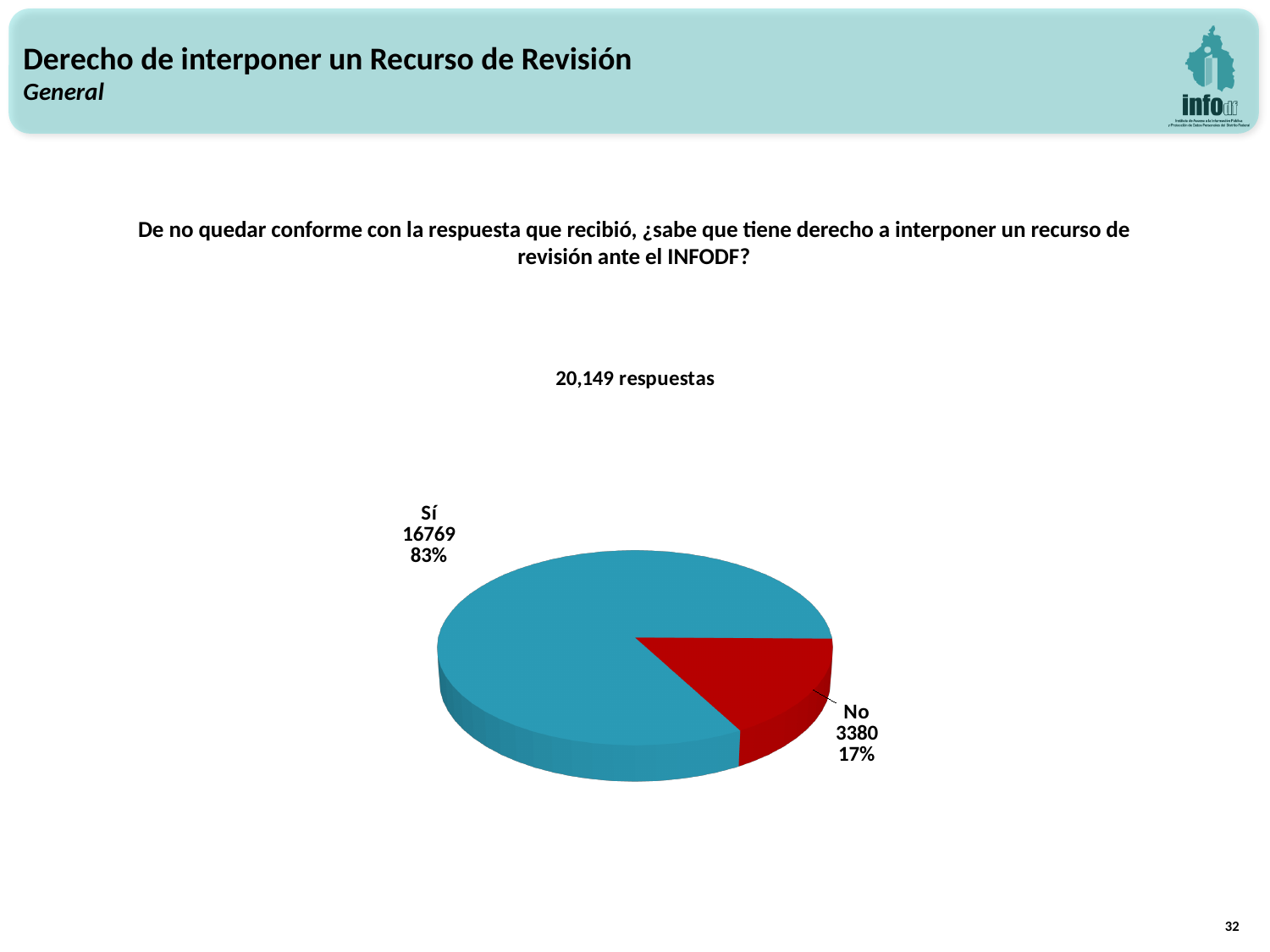
Which has more responses, "Sí" or "No"? Sí Which slice is the smallest? No What is the total number of responses shown above the chart? 20,149 respuestas What kind of chart is shown on the slide? pie chart What share of the pie does the "No" slice represent? 17% How many slices does the pie chart have? 2 Which slice is the largest? Sí What is the difference between the number of "Sí" and "No" responses? 13389 What share of the pie does the "Sí" slice represent? 83% What colour is the "No" slice? red What is the number of responses for "Sí"? 16769 What is the number of responses for "No"? 3380